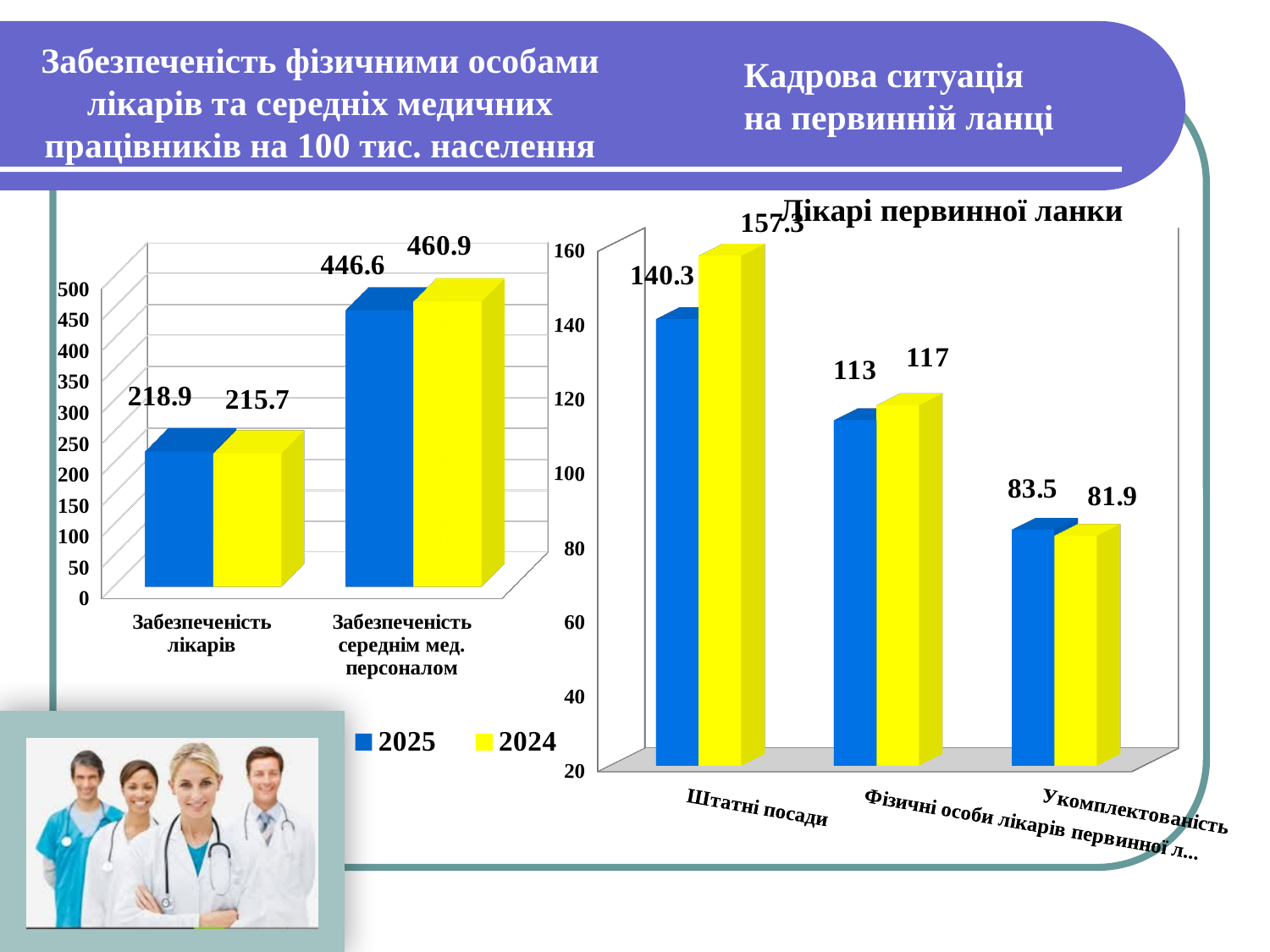
In the chart titled Лікарі первинної ланки, do the blue bar values rise or fall from left to right across the categories? Fall What type of chart is the left chart? Bar chart In the left chart, what is the 2024 value for Забезпеченість середнім мед. персоналом? 460.9 In the chart titled Лікарі первинної ланки, what is the difference between the yellow and blue bars for Штатні посади? 17 How many series does the legend of the left chart list? 2 In the chart titled Лікарі первинної ланки, which category has the lowest blue bar? Укомплектованість How many categories are shown in the chart titled Лікарі первинної ланки? 3 In the left chart, which is larger for Забезпеченість лікарів: the 2025 value or the 2024 value? 2025 In the left chart, what is the difference between the 2024 and 2025 values for Забезпеченість середнім мед. персоналом? 14.3 In the chart titled Лікарі первинної ланки, what is the value of the yellow bar for Штатні посади? 157.3 In the chart titled Лікарі первинної ланки, what is the value of the blue bar for Укомплектованість? 83.5 In the left chart, what is the 2025 value for Забезпеченість лікарів? 218.9